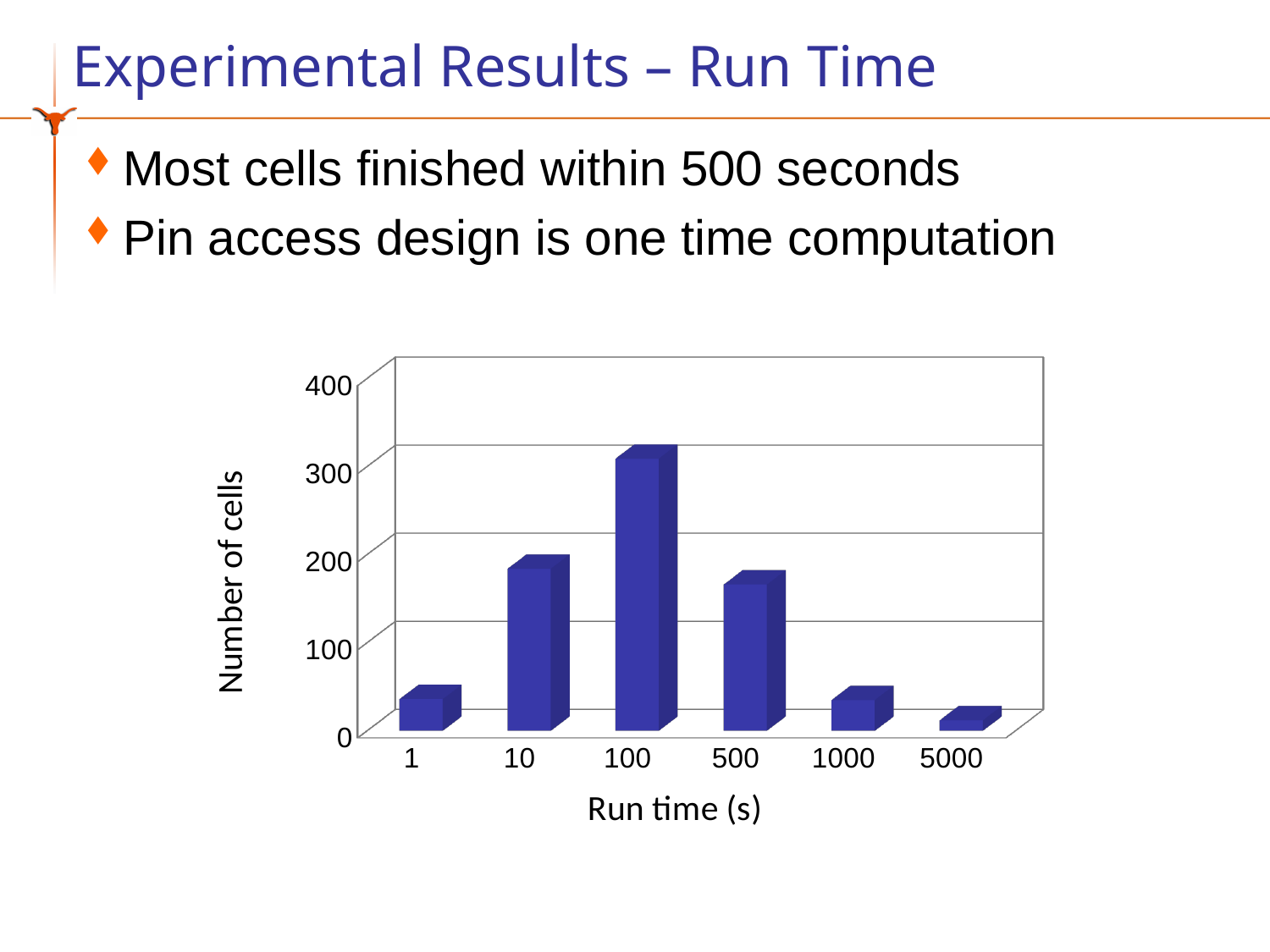
Which run time category has the highest number of cells? 100 Is the number of cells for run time 500 greater or less than 100? greater What is the label of the vertical axis of the chart? Number of cells Is the number of cells for run time 1000 greater or less than 100? less Is the number of cells for run time 1 greater or less than 100? less Which has more cells: run time 500 or run time 1000? 500 What kind of chart is shown on the slide? bar chart How many run time categories are shown on the x axis of the chart? 6 Do the values rise or fall along the x axis from run time 100 to run time 5000? fall Which has more cells: run time 100 or run time 10? 100 Which run time category has the lowest number of cells? 5000